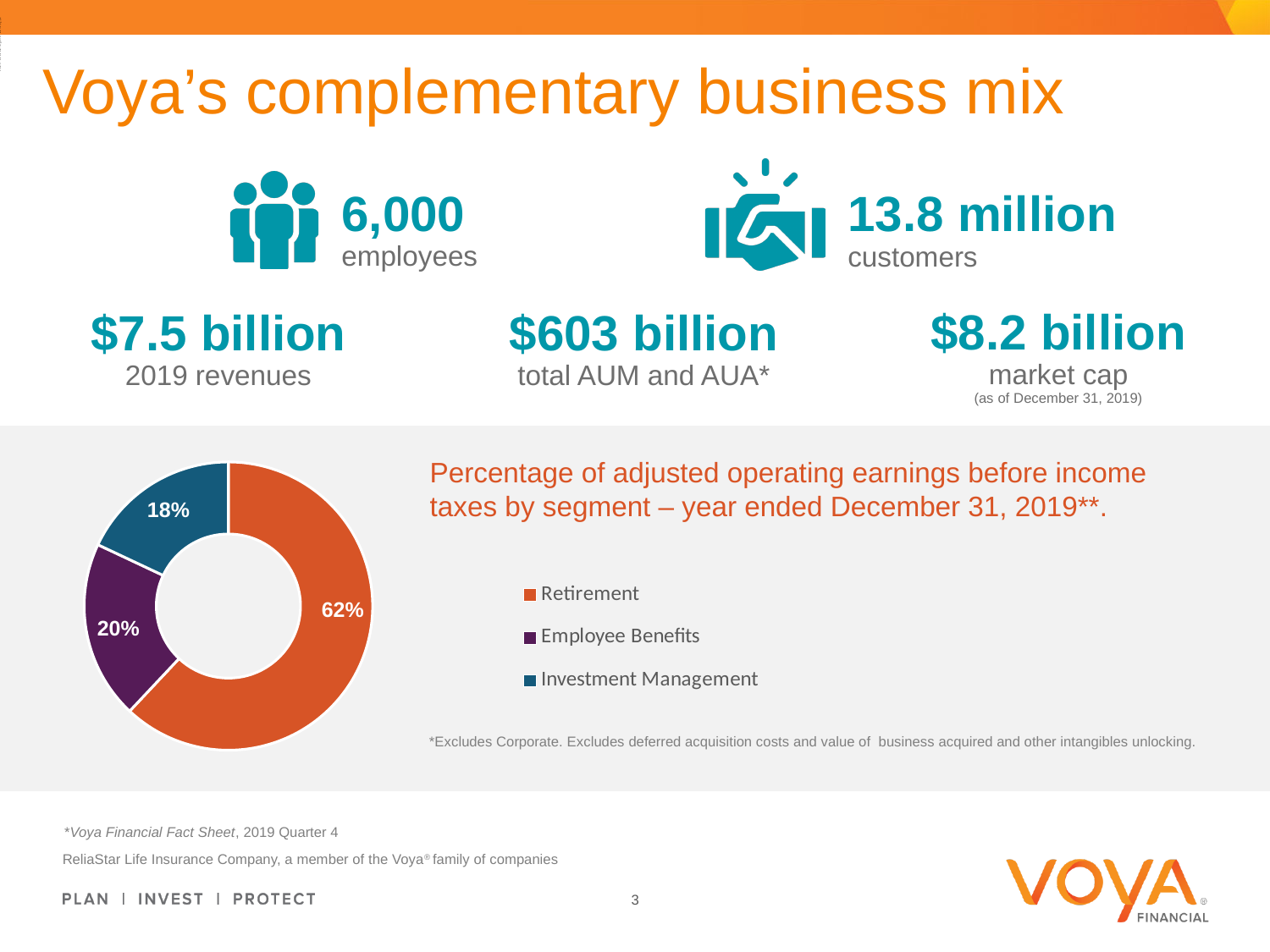
What percentage of adjusted operating earnings before income taxes does the Investment Management segment represent? 18% What percentage of adjusted operating earnings before income taxes does the Retirement segment represent? 62% What percentage of adjusted operating earnings before income taxes does the Employee Benefits segment represent? 20% What colour represents the Retirement segment in the chart? Orange What is the difference in percentage points between the Employee Benefits and Investment Management segments? 2 How many segments are shown in the chart? 3 Which segment has the smallest share of adjusted operating earnings before income taxes? Investment Management What is the difference in percentage points between the Retirement and Employee Benefits segments? 42 Which segment has a larger share: Employee Benefits or Investment Management? Employee Benefits Which segment has the largest share of adjusted operating earnings before income taxes? Retirement What type of chart is used to show the percentage of adjusted operating earnings by segment? Donut (pie) chart How many entries does the chart legend list? 3